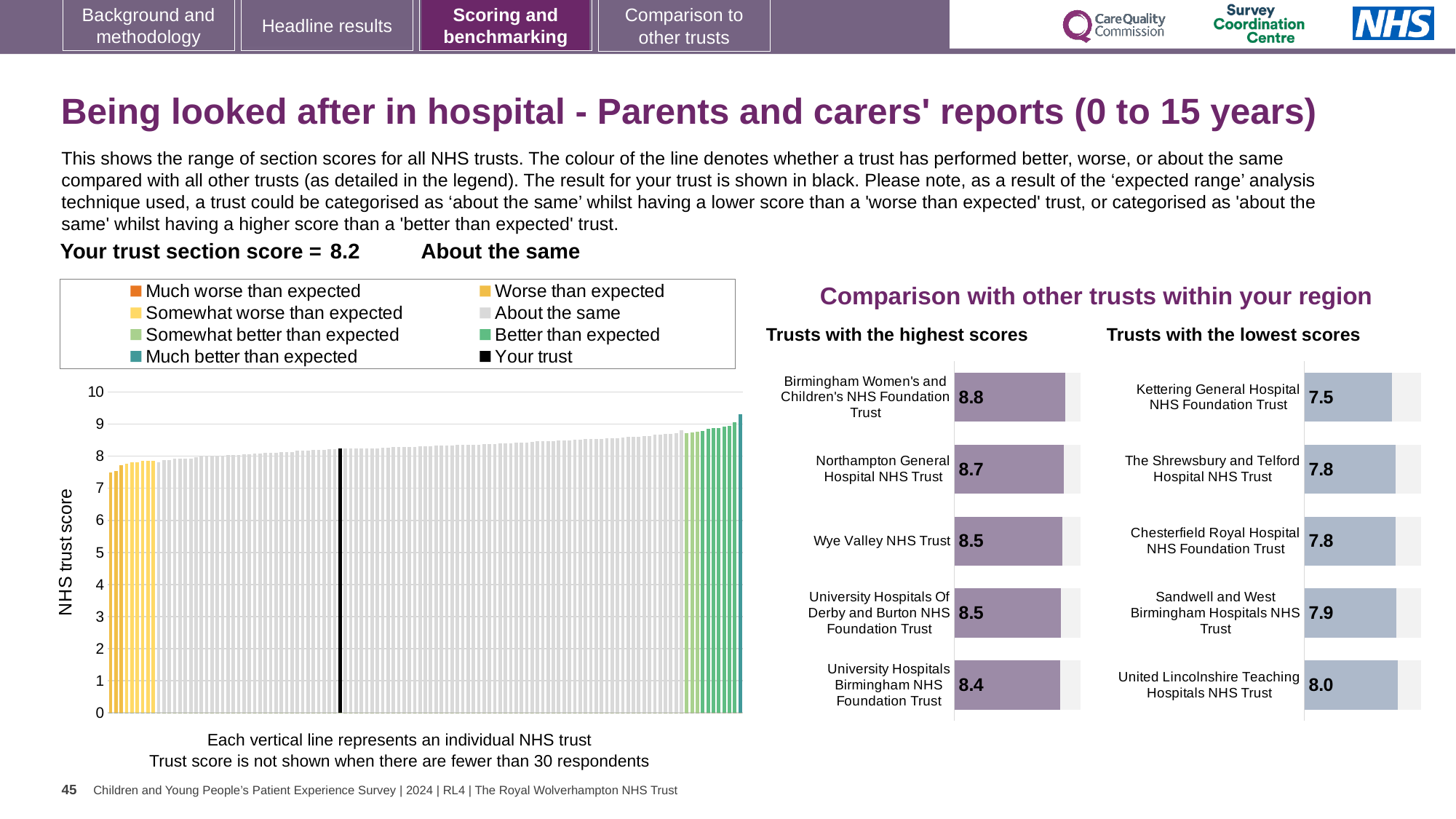
How many entries does the legend above the large chart on the left list? 8 In the 'Trusts with the highest scores' chart, which trust has the lowest score? University Hospitals Birmingham NHS Foundation Trust In the 'Trusts with the highest scores' chart, what is the difference between the scores of Birmingham Women's and Children's NHS Foundation Trust and University Hospitals Birmingham NHS Foundation Trust? 0.4 In the large chart on the left, do the bar values rise or fall from left to right? rise In the 'Trusts with the lowest scores' chart, which trust has the highest score? United Lincolnshire Teaching Hospitals NHS Trust In the 'Trusts with the highest scores' chart, what is the score for Birmingham Women's and Children's NHS Foundation Trust? 8.8 In the 'Trusts with the lowest scores' chart, which has the larger score: Kettering General Hospital NHS Foundation Trust or Sandwell and West Birmingham Hospitals NHS Trust? Sandwell and West Birmingham Hospitals NHS Trust In the 'Trusts with the lowest scores' chart, what is the score for Kettering General Hospital NHS Foundation Trust? 7.5 What kind of chart is the large chart on the left showing the range of section scores for all NHS trusts? bar chart In the large chart on the left, what is the label on the vertical axis? NHS trust score In the large chart on the left, is the value for the black bar (your trust) greater or less than 5? greater How many trusts are shown in the 'Trusts with the highest scores' chart? 5